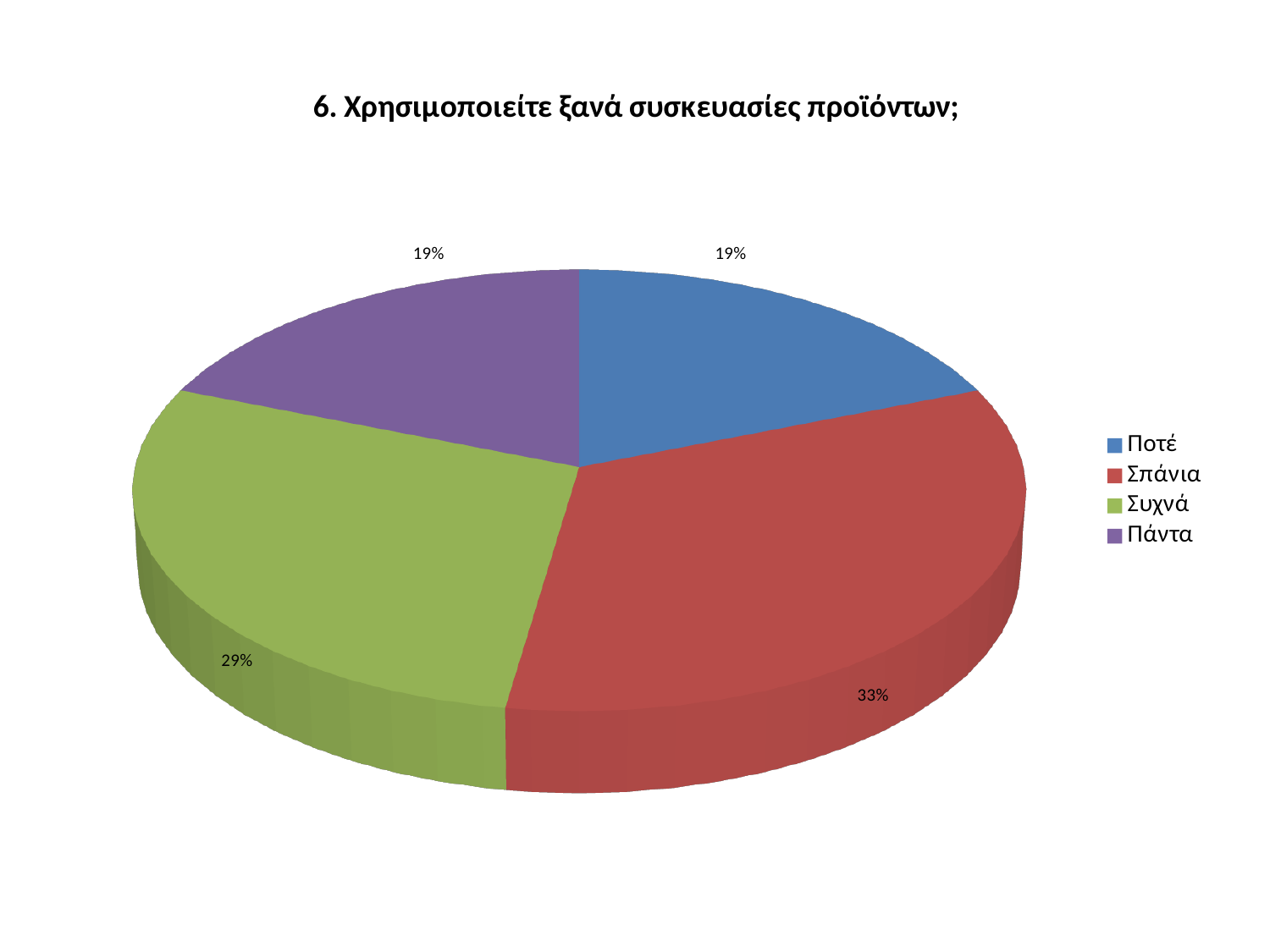
What percentage is shown for Συχνά? 29% What is the difference in percentage points between Σπάνια and Πάντα? 14 How many categories does the legend list? 4 What percentage is shown for Πάντα? 19% What is the difference in percentage points between Σπάνια and Συχνά? 4 What is the title of the chart? 6. Χρησιμοποιείτε ξανά συσκευασίες προϊόντων; Which colour represents Συχνά in the legend? green What kind of chart is shown on the slide? pie chart Which is larger, the share for Συχνά or the share for Ποτέ? Συχνά What percentage is shown for Σπάνια? 33% Which category has the largest share of the pie? Σπάνια What percentage is shown for Ποτέ? 19%